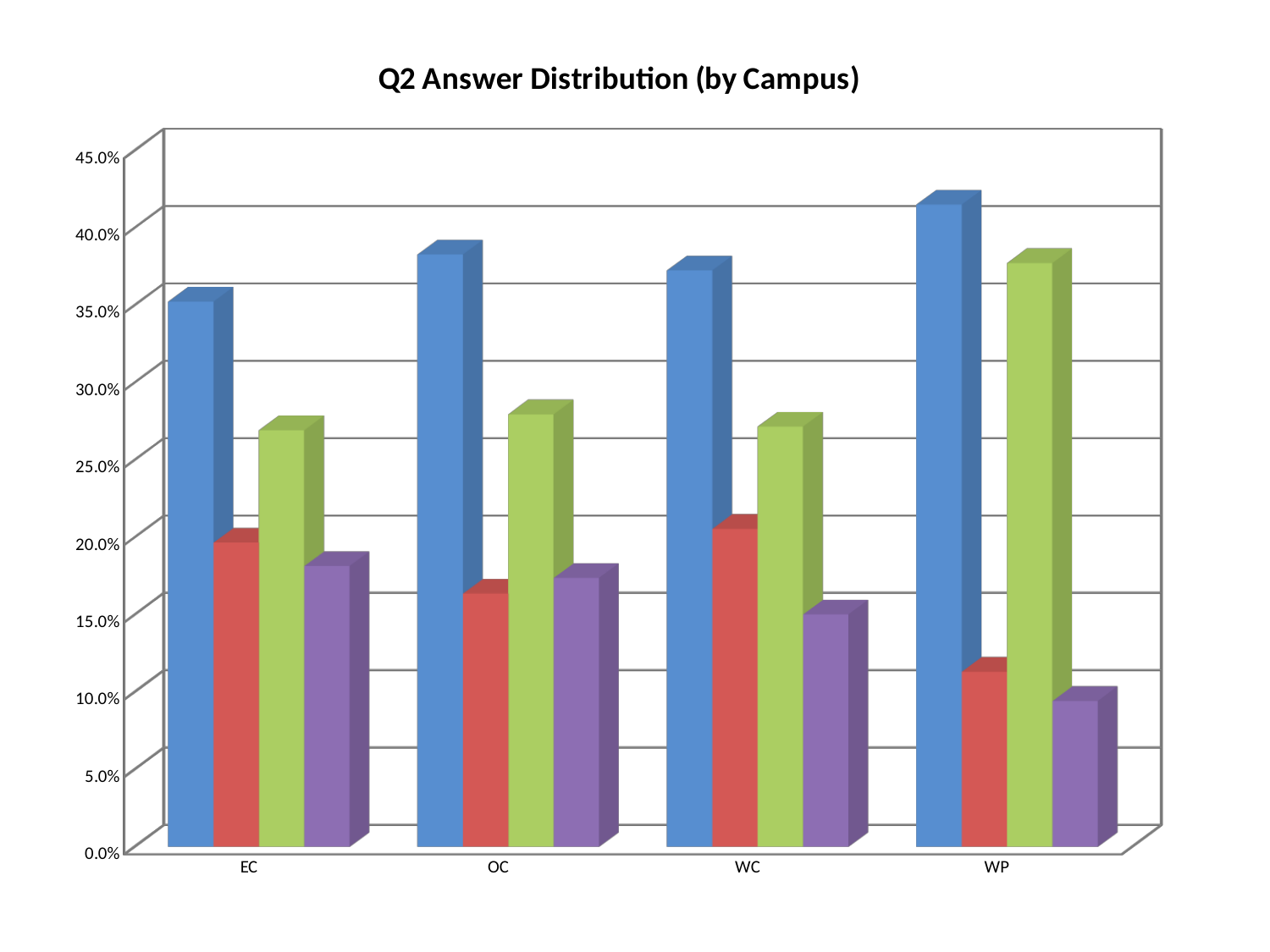
Is the red bar for WP greater or less than 15.0%? less Is the green bar for WP greater or less than 35.0%? greater Which campus has the shortest purple bar? WP Which is larger, the green bar for WP or the green bar for EC? WP How many campuses are shown on the x axis? 4 How many bars are plotted for each campus? 4 What is the title of the chart? Q2 Answer Distribution (by Campus) Is the green bar for OC greater or less than 25.0%? greater Which campus has the tallest blue bar? WP Which campus has the shortest red bar? WP What type of chart is shown on the slide? bar chart